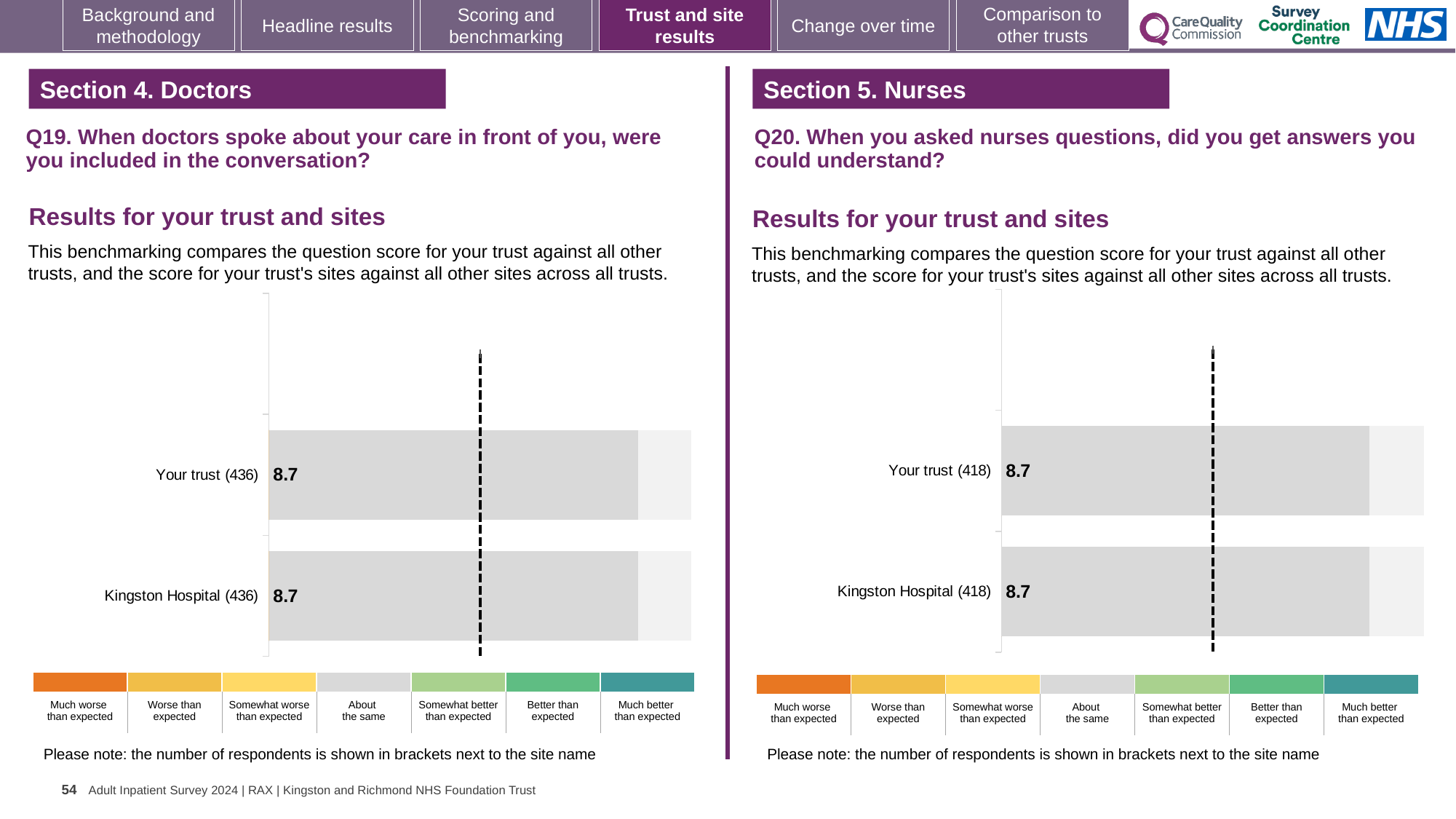
What kind of chart is used for the Q19 results on the left? Bar chart In the Q19 chart on the left, what is the difference between the scores for Your trust and Kingston Hospital? 0 In the Q20 chart on the right, what is the score for Kingston Hospital? 8.7 How many bars are plotted in the Q19 chart on the left? 2 In the Q20 chart on the right, what is the score for Your trust? 8.7 In the Q20 chart on the right, how many respondents are shown in brackets for Kingston Hospital? 418 In the Q20 chart on the right, is the score for Your trust greater or less than 5? greater How many bars are plotted in the Q20 chart on the right? 2 In the Q19 chart on the left, what is the score for Your trust? 8.7 In the Q19 chart on the left, how many respondents are shown in brackets for Your trust? 436 In the Q19 chart on the left, what is the score for Kingston Hospital? 8.7